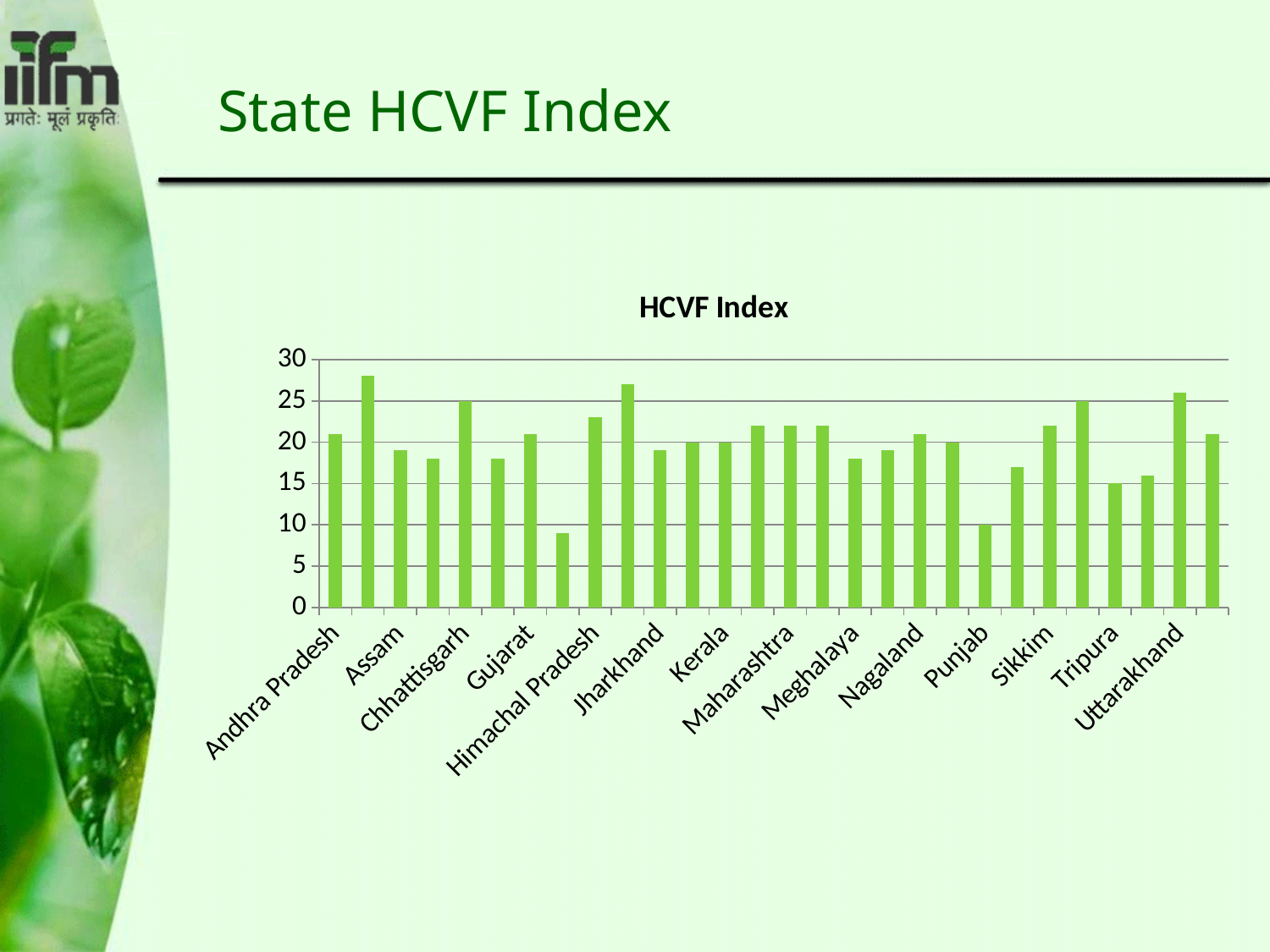
Is the value for Meghalaya greater or less than 20? less Is the value for Chhattisgarh greater or less than 20? greater How many bars are plotted in the chart? 28 What is the title of the chart? HCVF Index Which has the larger HCVF Index value, Himachal Pradesh or Punjab? Himachal Pradesh Is the value for Himachal Pradesh greater or less than 20? greater What is the highest value shown on the vertical axis? 30 What kind of chart is shown on the slide? bar chart Which has the larger HCVF Index value, Chhattisgarh or Tripura? Chhattisgarh